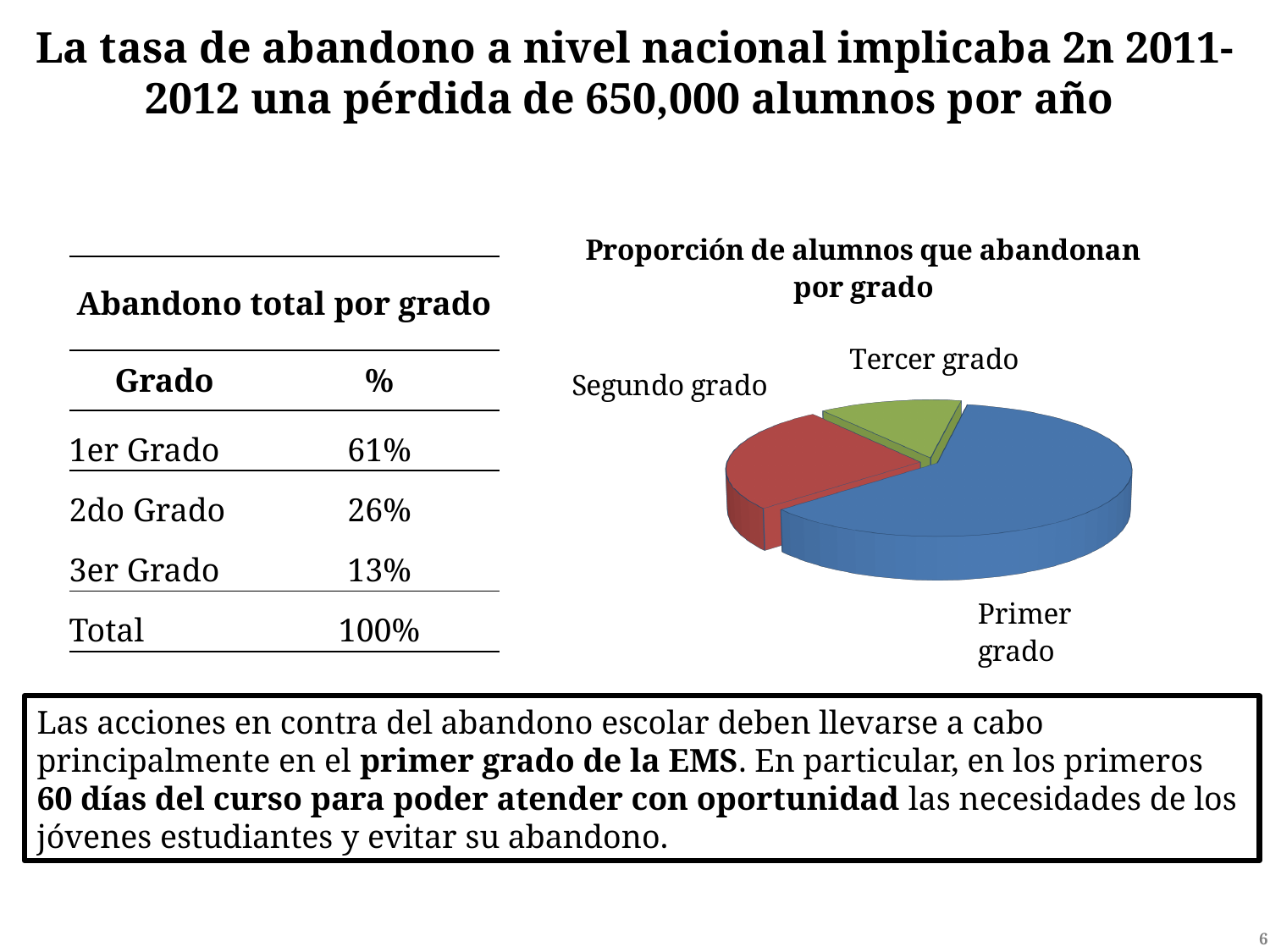
Which grade has the smallest slice in the pie chart? Tercer grado How many slices does the pie chart have? 3 What is the title of the pie chart? Proporción de alumnos que abandonan por grado Is the Primer grado slice more or less than half of the pie chart? more What colour is the Primer grado slice in the pie chart? blue Which grade has the largest slice in the pie chart? Primer grado According to the slide, what share of students who drop out are in Segundo grado? 26% What kind of chart is shown on the slide? pie chart According to the slide, what share of students who drop out are in Tercer grado? 13% According to the slide, what share of students who drop out are in Primer grado? 61% Which slice is larger in the pie chart, Primer grado or Segundo grado? Primer grado Which slice is larger in the pie chart, Segundo grado or Tercer grado? Segundo grado